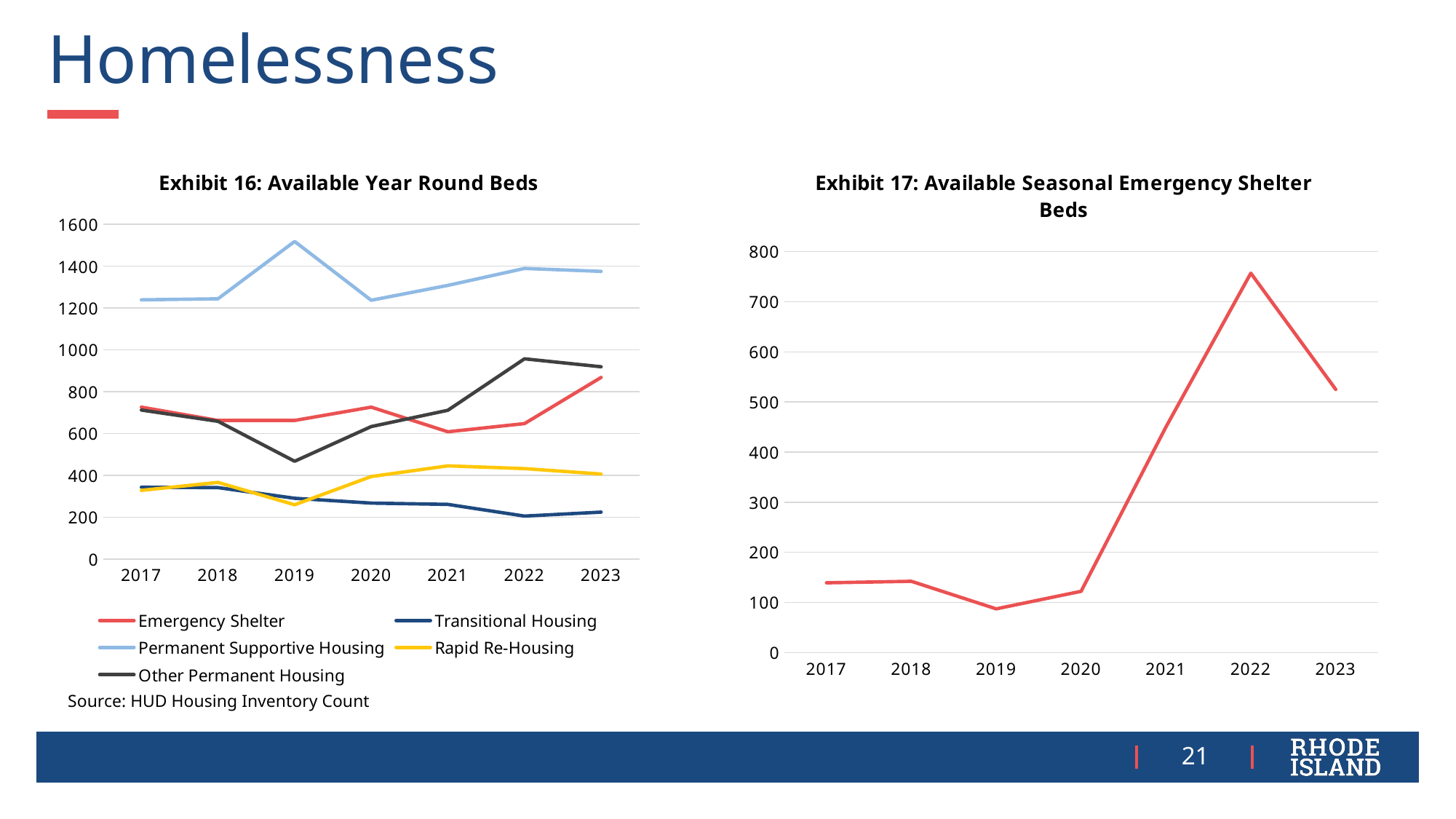
In Exhibit 17: Available Seasonal Emergency Shelter Beds, which year has the highest value? 2022 In Exhibit 16: Available Year Round Beds, in which year does Permanent Supportive Housing reach its highest value? 2019 In Exhibit 16: Available Year Round Beds, is the value for Permanent Supportive Housing in 2019 greater or less than 1400? greater In Exhibit 16: Available Year Round Beds, which is larger in 2023, Rapid Re-Housing or Transitional Housing? Rapid Re-Housing What source is cited below the charts on the slide? HUD Housing Inventory Count In Exhibit 16: Available Year Round Beds, in which year is Other Permanent Housing at its lowest? 2019 How many years are shown on the x axis of Exhibit 17: Available Seasonal Emergency Shelter Beds? 7 What kind of chart is Exhibit 16: Available Year Round Beds? line chart In Exhibit 17: Available Seasonal Emergency Shelter Beds, is the value for 2019 greater or less than 100? less In Exhibit 16: Available Year Round Beds, which series has the highest values across all years? Permanent Supportive Housing How many series does the legend of Exhibit 16: Available Year Round Beds list? 5 In Exhibit 16: Available Year Round Beds, does Transitional Housing generally rise or fall from 2017 to 2023? fall